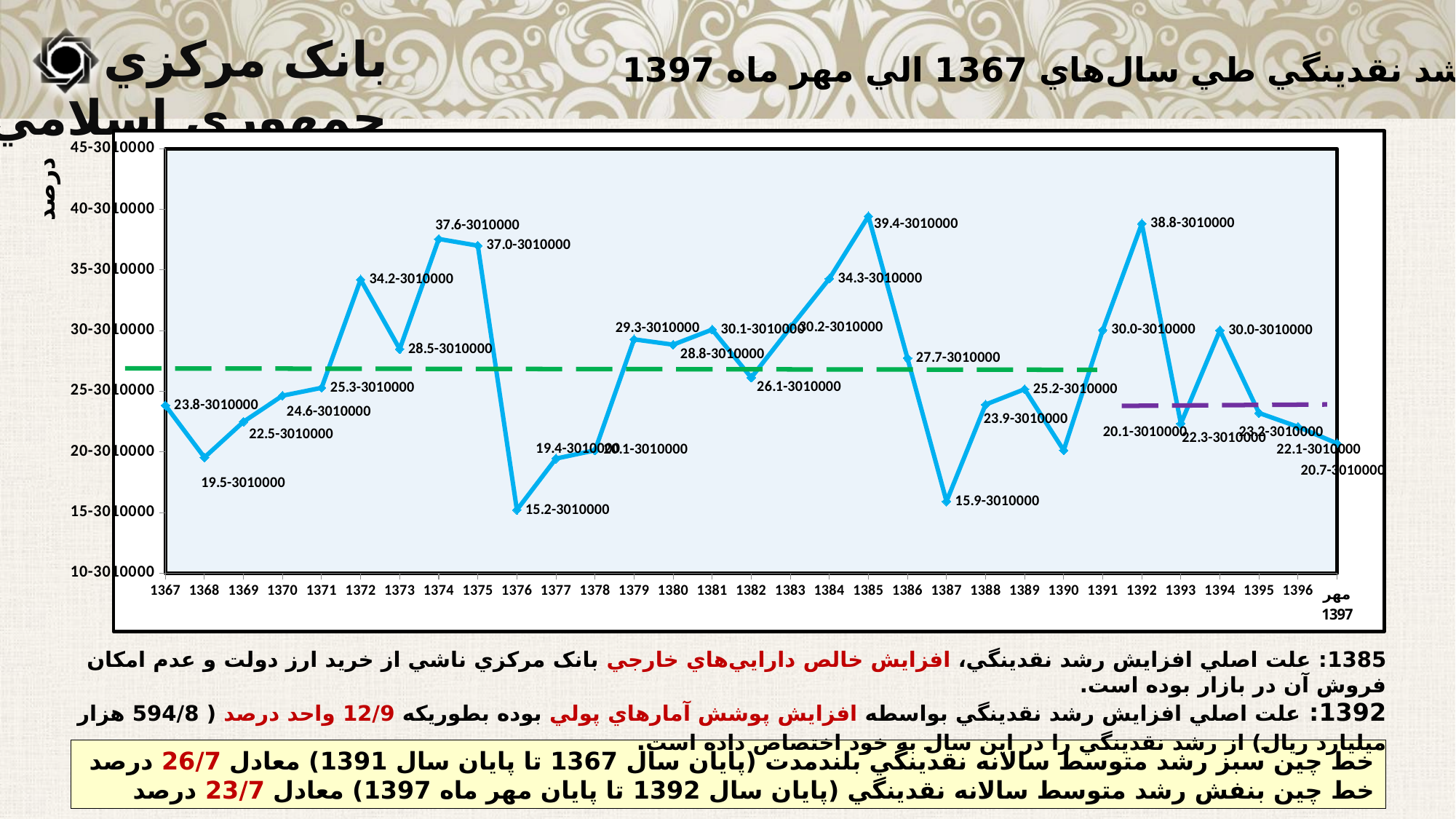
How many data points are plotted on the line chart (from 1367 to Mehr 1397)? 31 What data label is printed for the year 1392? 38.8-3010000 What data label is printed for Mehr 1397, the last point on the chart? 20.7-3010000 Which year has the highest value on the line chart? 1385 Do the values rise or fall from 1376 to 1379? rise What kind of chart is shown on the slide? line chart Which year has the lowest value on the line chart? 1376 What data label is printed for the year 1385? 39.4-3010000 What data label is printed for the year 1376? 15.2-3010000 Which year has the larger value, 1374 or 1375? 1374 According to the note below the chart, what average growth rate does the green dashed line represent? 26/7 درصد Is the value for 1372 greater or less than 30? greater